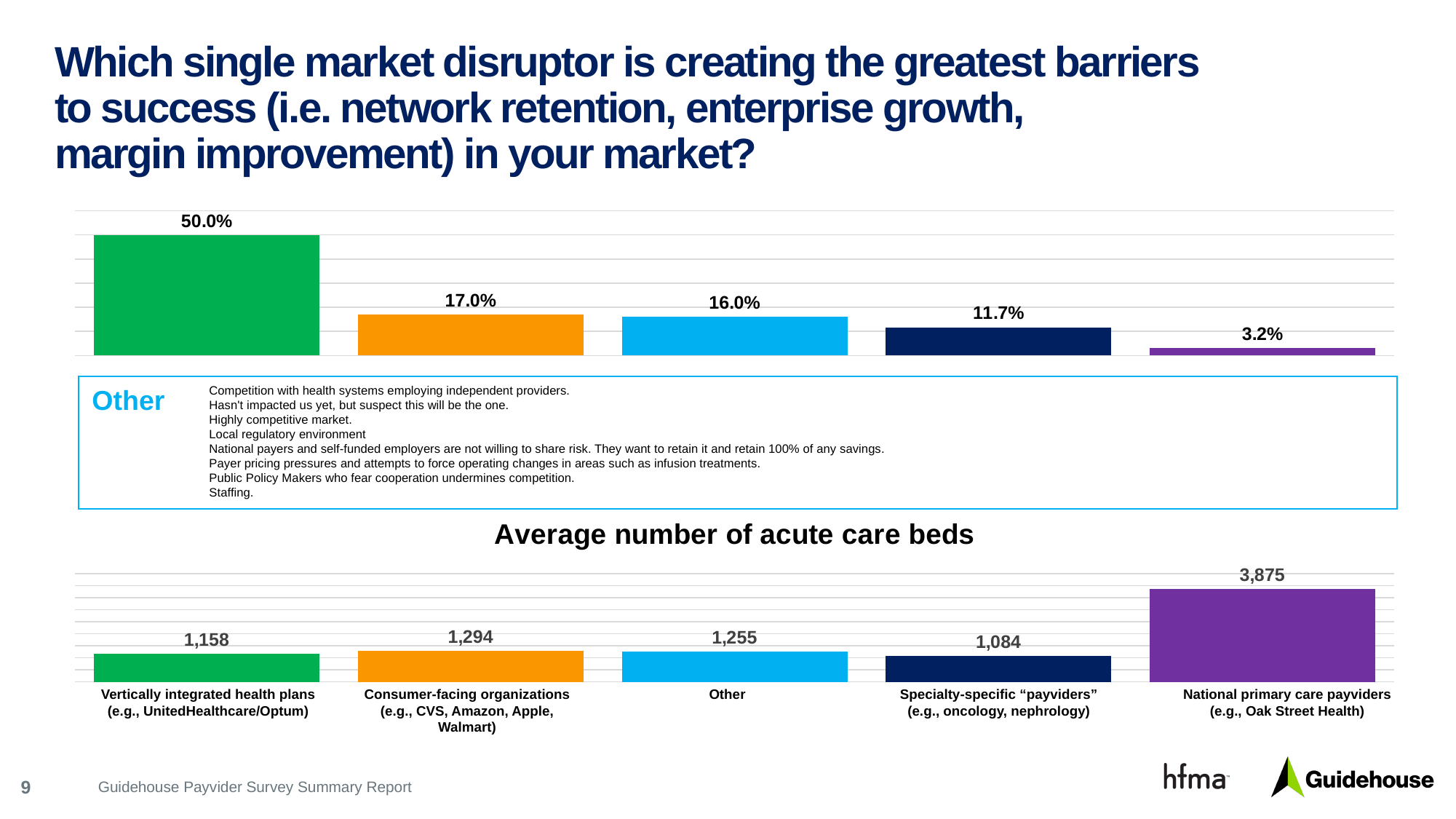
How many categories are shown in the top chart? 5 In the top chart, what percentage is shown for national primary care payviders? 3.2% In the 'Average number of acute care beds' chart, what is the value for specialty-specific payviders? 1,084 In the top chart, which is larger: the percentage for consumer-facing organizations or for specialty-specific payviders? Consumer-facing organizations In the 'Average number of acute care beds' chart, which category has the highest value? National primary care payviders In the 'Average number of acute care beds' chart, what is the difference between consumer-facing organizations and vertically integrated health plans? 136 What type of chart is the 'Average number of acute care beds' chart? Bar chart In the 'Average number of acute care beds' chart, what is the value for national primary care payviders? 3,875 In the top chart, which category has the lowest percentage? National primary care payviders In the top chart, what percentage of respondents selected vertically integrated health plans as the greatest barrier? 50.0% In the top chart, what is the difference in percentage points between vertically integrated health plans and consumer-facing organizations? 33.0 percentage points What colour is the bar for the 'Other' category in both charts? Light blue